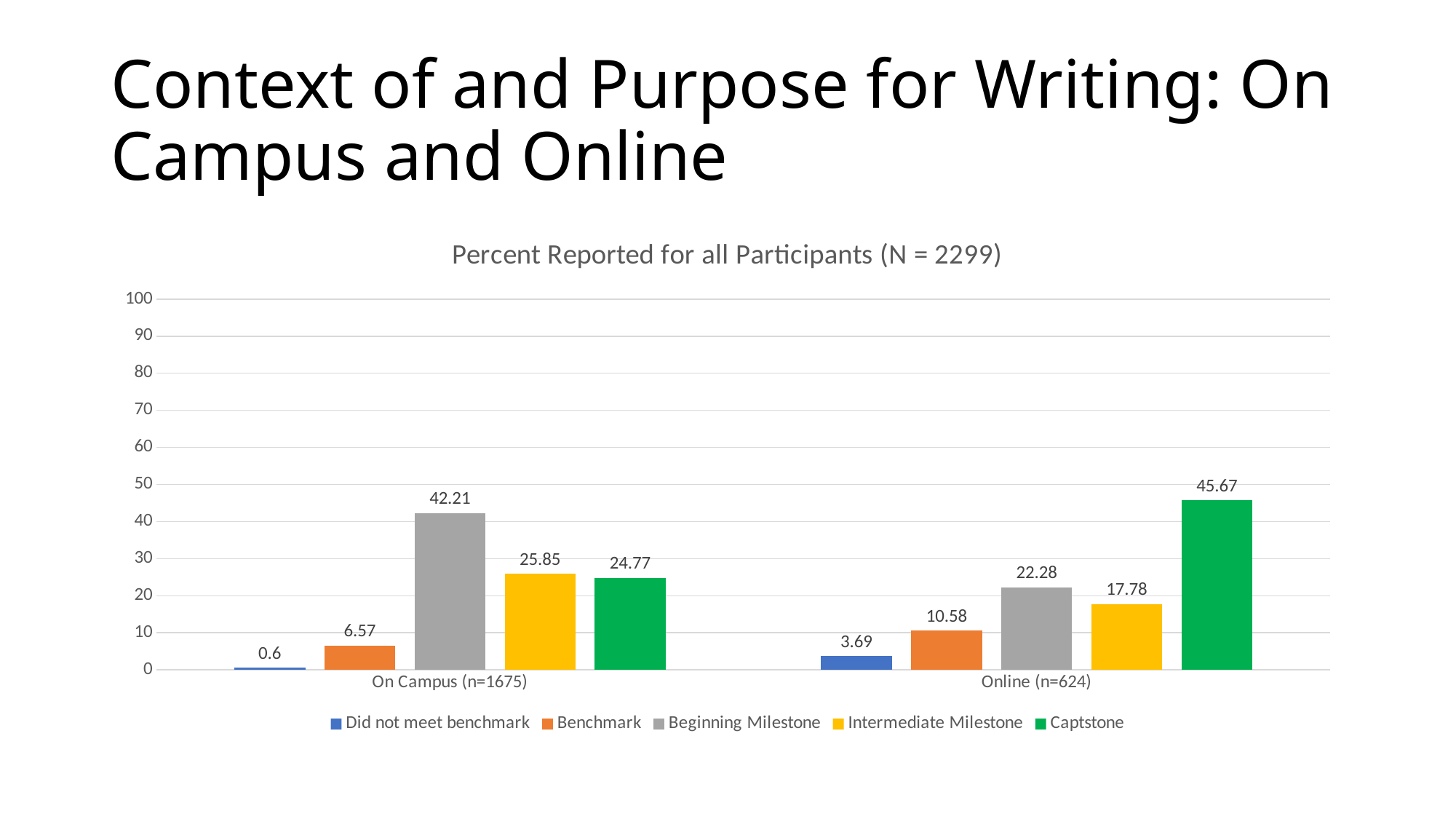
What is the title of the chart? Percent Reported for all Participants (N = 2299) Which series has the highest value in the Online (n=624) group? Captstone How many series does the legend list? 5 How many categories are shown on the x axis? 2 What is the value for Beginning Milestone in the On Campus (n=1675) group? 42.21 What is the difference between the Beginning Milestone values for On Campus (n=1675) and Online (n=624)? 19.93 What kind of chart is shown on the slide? Bar chart Which is larger: Intermediate Milestone for On Campus (n=1675) or Intermediate Milestone for Online (n=624)? On Campus (n=1675) Which series has the lowest value in the On Campus (n=1675) group? Did not meet benchmark What is the value for Captstone in the Online (n=624) group? 45.67 What is the value for Benchmark in the Online (n=624) group? 10.58 What is the value for Did not meet benchmark in the On Campus (n=1675) group? 0.6